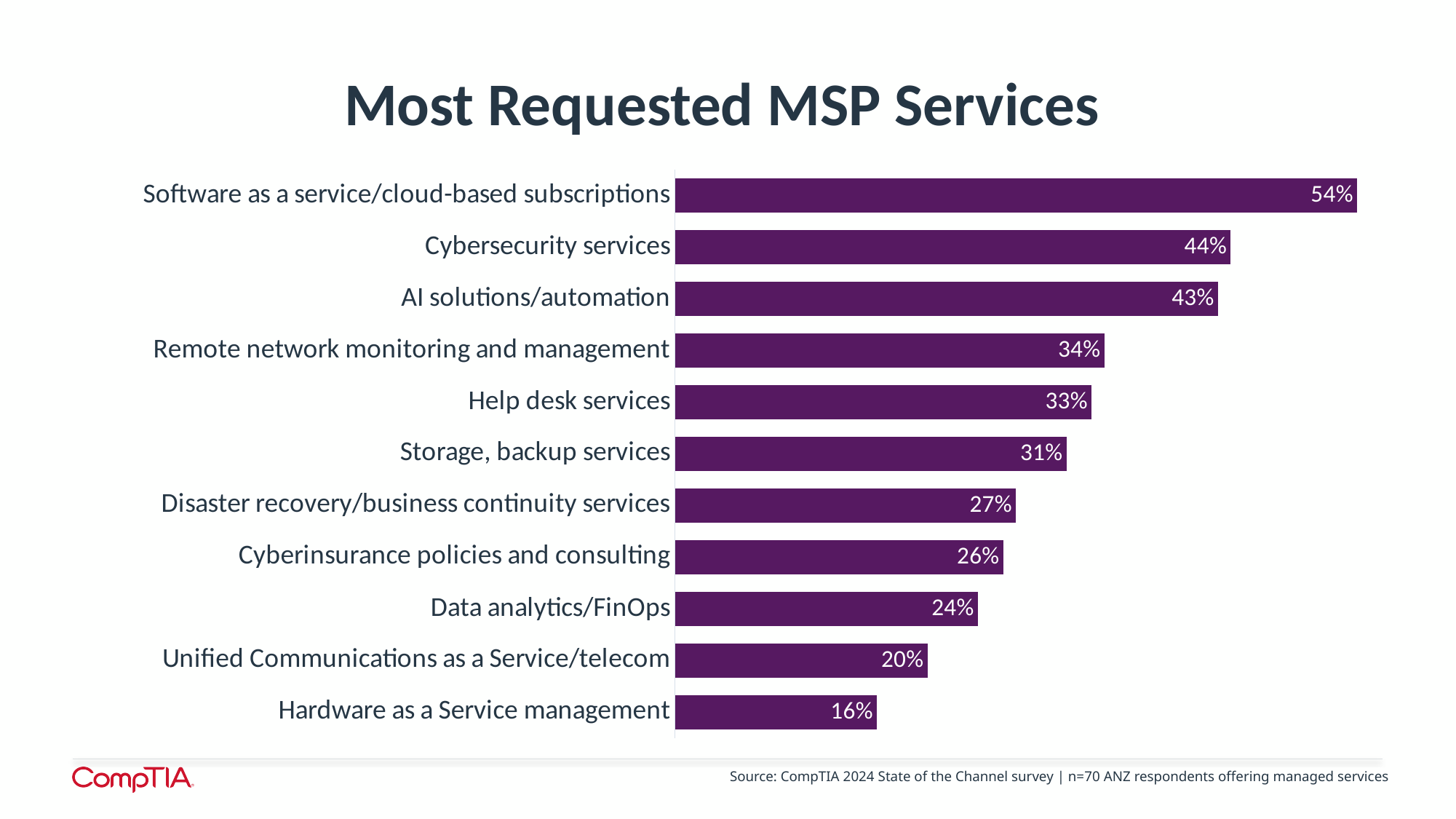
What is the difference between Storage, backup services and Hardware as a Service management? 15% What kind of chart is shown on the slide? Bar chart What percentage is shown for Data analytics/FinOps? 24% What is the value for Help desk services? 33% What percentage is shown for Cybersecurity services? 44% Which is larger: Unified Communications as a Service/telecom or Cyberinsurance policies and consulting? Cyberinsurance policies and consulting How many services are shown in the chart? 11 What is the difference between Software as a service/cloud-based subscriptions and Cybersecurity services? 10% Which service has the highest value? Software as a service/cloud-based subscriptions What is the title of the chart? Most Requested MSP Services Which service has the lowest value? Hardware as a Service management Which is larger: Remote network monitoring and management or Disaster recovery/business continuity services? Remote network monitoring and management